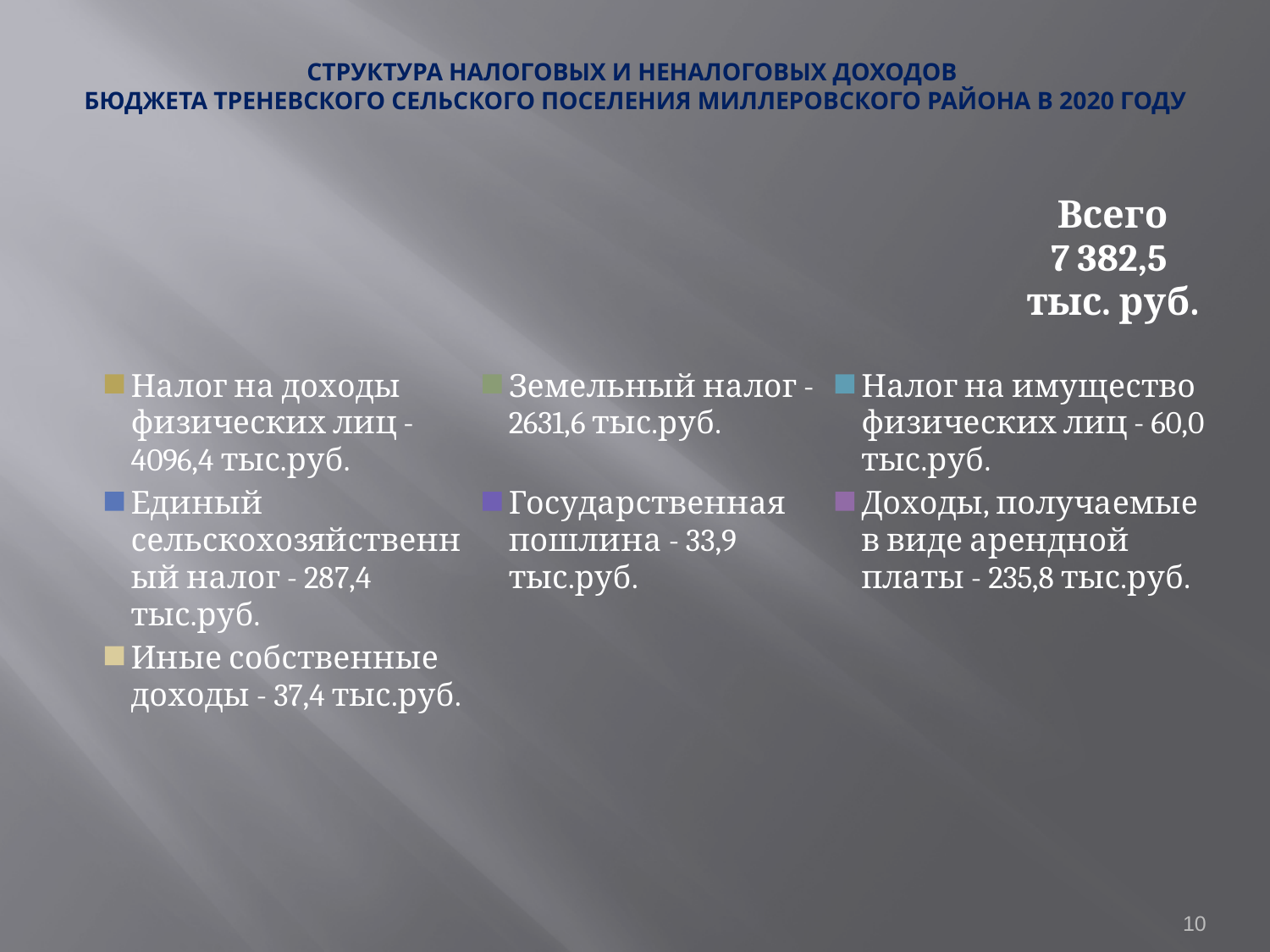
What is the value for Единый сельскохозяйственный налог? 287,4 тыс.руб. What is the value for Налог на доходы физических лиц? 4096,4 тыс.руб. Which category has the highest value? Налог на доходы физических лиц Which is larger: Единый сельскохозяйственный налог or Доходы, получаемые в виде арендной платы? Единый сельскохозяйственный налог What total (Всего) is shown on the slide? 7 382,5 тыс. руб. What year does the slide title refer to? 2020 What is the value for Земельный налог? 2631,6 тыс.руб. What is the value for Государственная пошлина? 33,9 тыс.руб. How many categories does the legend list? 7 What is the difference between Налог на имущество физических лиц and Иные собственные доходы? 22,6 тыс.руб. Which category has the lowest value? Государственная пошлина What is the value for Доходы, получаемые в виде арендной платы? 235,8 тыс.руб.